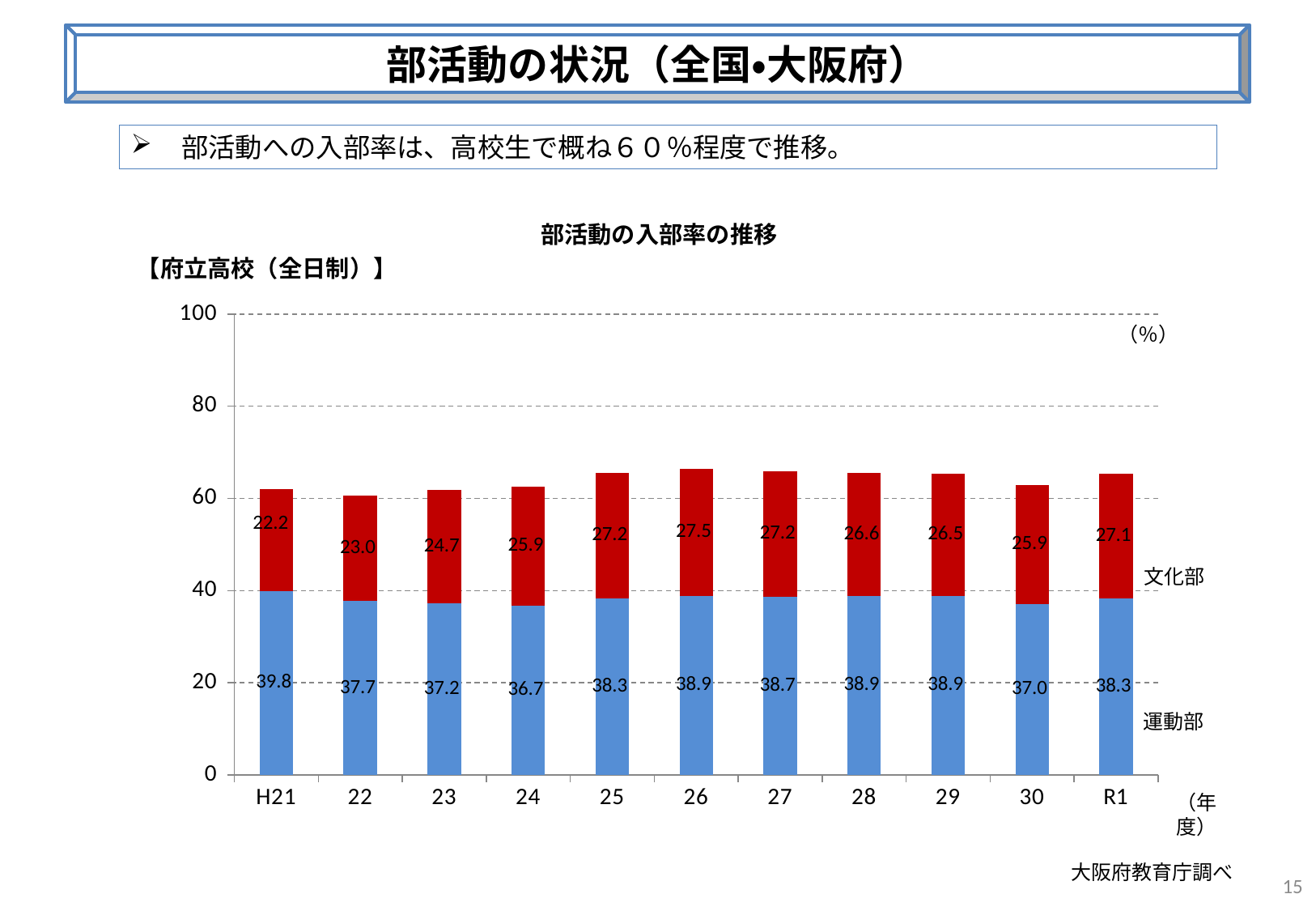
What is the value for 文化部 in 26? 27.5 How many years (categories) are shown on the x axis of the chart? 11 Which series is shown in red in the chart? 文化部 In which year is the 文化部 value the highest? 26 What is the total of the stacked bar for 26? 66.4 What kind of chart is shown on the slide? Stacked bar chart How many series does the chart show? 2 What is the difference between the 文化部 values in R1 and H21? 4.9 What is the value for 運動部 in H21? 39.8 In which year is the 文化部 value the lowest? H21 In which year is the 運動部 value the lowest? 24 What is the value for 文化部 in R1? 27.1